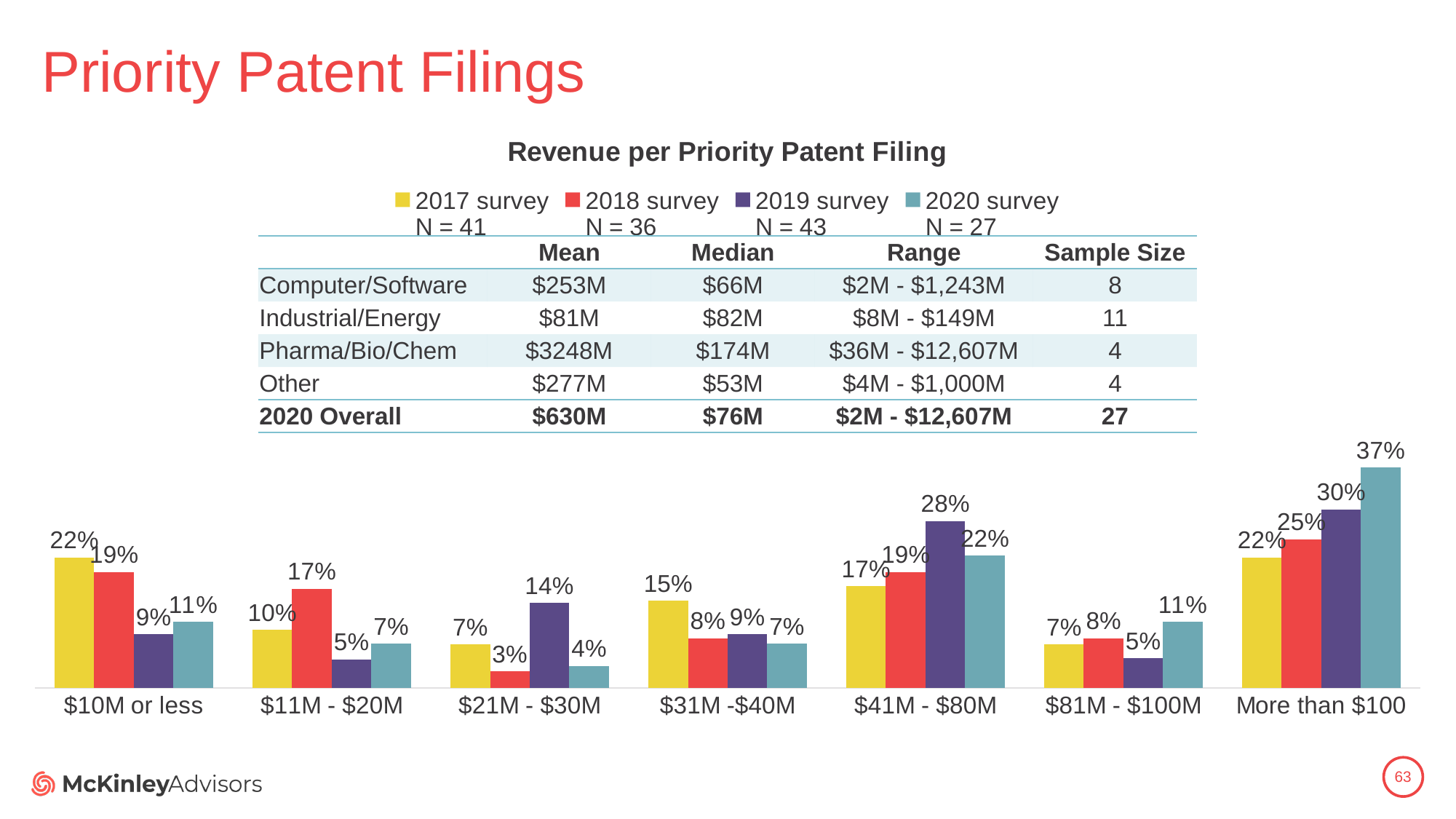
Which category has the highest 2020 survey value? More than $100 What is the 2017 survey value for the '$31M -$40M' category? 15% What kind of chart is shown on the slide? Bar chart Which is larger for the '$10M or less' category: the 2017 survey value or the 2019 survey value? 2017 survey What is the difference between the 2020 survey and 2017 survey values for 'More than $100'? 15% How many series does the chart legend list? 4 What is the 2018 survey value for the '$21M - $30M' category? 3% What is the 2020 survey value for the 'More than $100' category? 37% How many revenue categories are shown on the x axis of the chart? 7 What is the title of the chart? Revenue per Priority Patent Filing What is the 2019 survey value for the '$41M - $80M' category? 28%